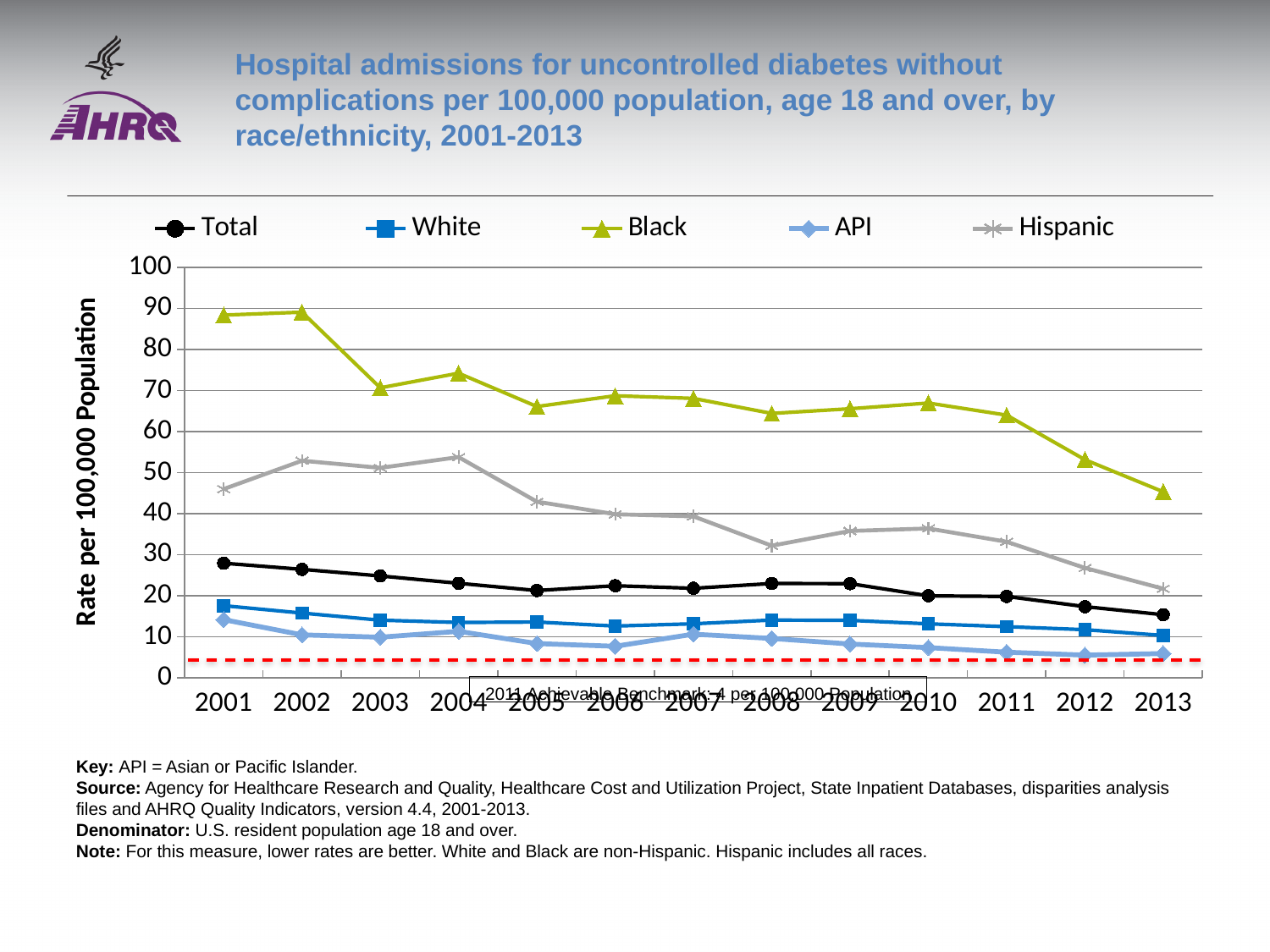
Which race/ethnicity group has the lowest rate in 2013? API How many years are plotted along the x axis? 13 Is the value for Hispanic in 2013 greater or less than 30? less Is the value for Black in 2001 greater or less than 80? greater How many series does the legend list? 5 Does the rate for Black rise or fall from 2001 to 2013? Fall Is the value for Total in 2013 greater or less than 20? less Which race/ethnicity group has the highest rate in 2001? Black What is the 2011 Achievable Benchmark shown by the dashed red line? 4 per 100,000 Population What kind of chart is shown on the slide? Line chart In 2005, which is larger, the rate for Black or the rate for Hispanic? Black What is the label of the y axis? Rate per 100,000 Population